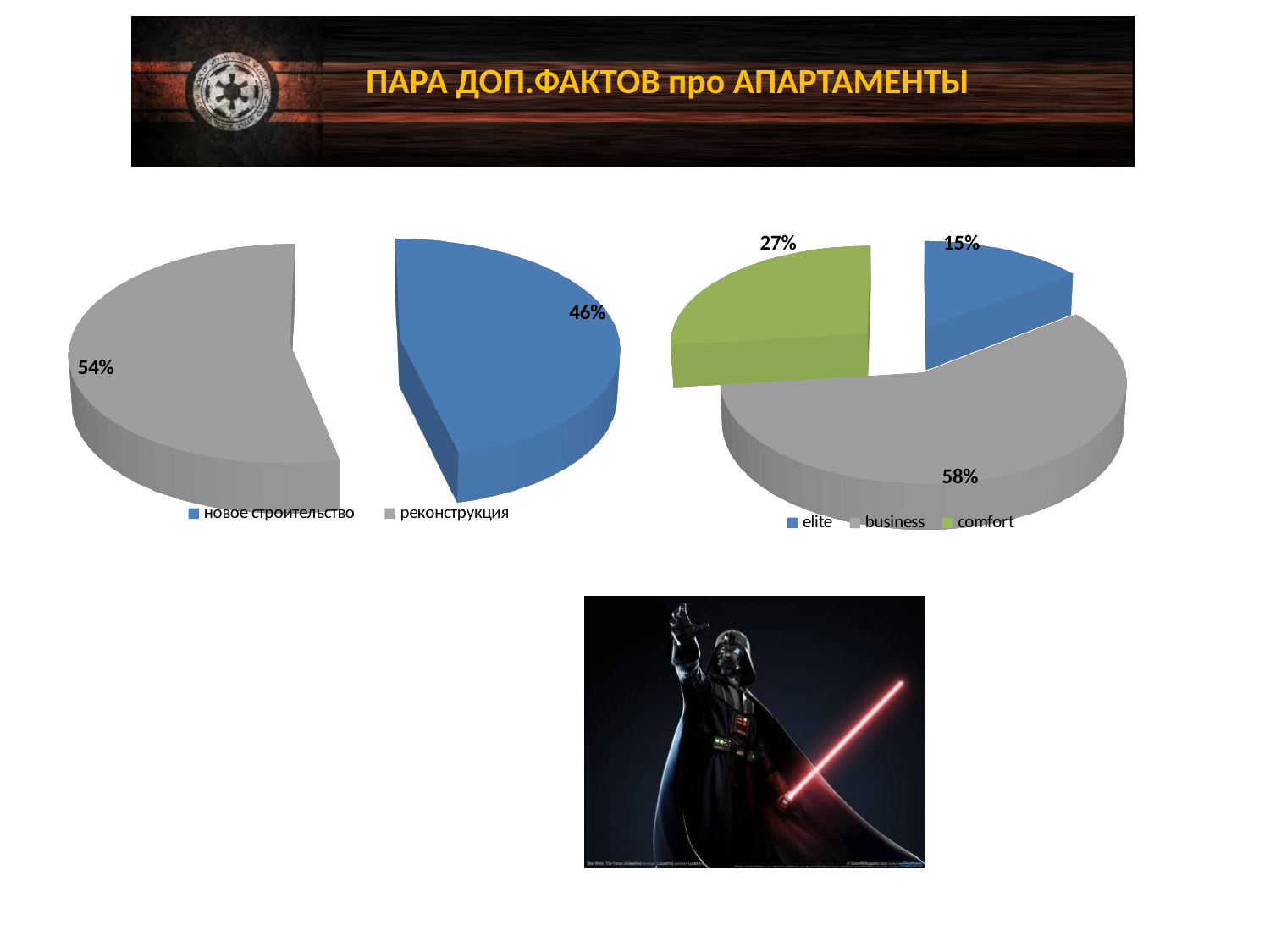
On the right pie chart, which category has the largest share? business On the right pie chart, what share is labelled for elite? 15% On the right pie chart, what colour is the comfort slice? green On the left pie chart, what share is labelled for новое строительство? 46% On the left pie chart, what share is labelled for реконструкция? 54% On the right pie chart, what share is labelled for business? 58% On the left pie chart, which category has the larger share? реконструкция On the right pie chart, which category has the smallest share? elite On the left pie chart, what is the difference in percentage points between реконструкция and новое строительство? 8 On the right pie chart, what share is labelled for comfort? 27% On the right pie chart, how many categories does the legend list? 3 What type of chart is the right chart on the slide? pie chart